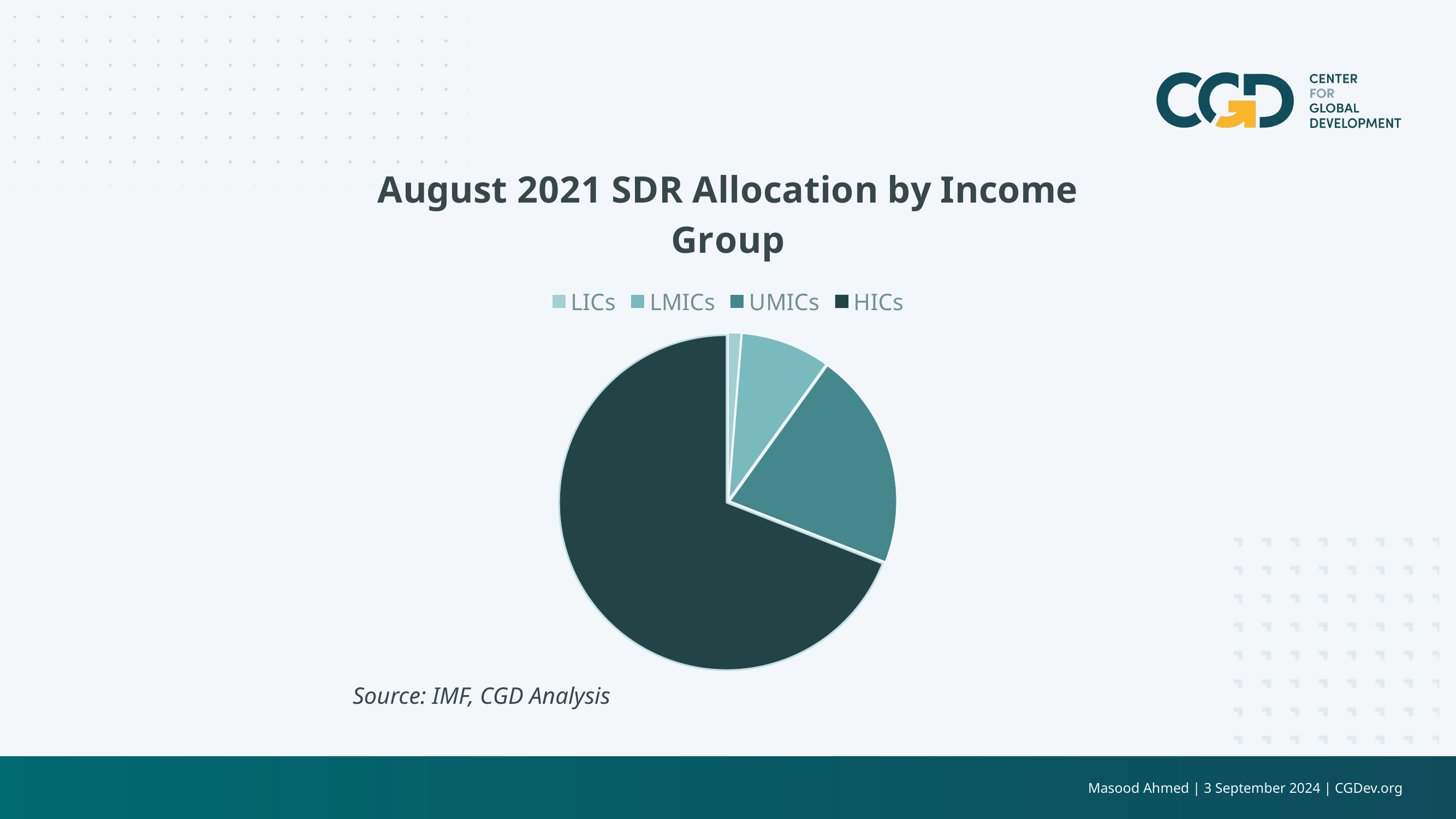
Which received a larger share of the SDR allocation, LICs or HICs? HICs What kind of chart is shown on the slide? Pie chart How many income groups (slices) does the pie chart show? 4 Which received a larger share of the SDR allocation, UMICs or LMICs? UMICs Which income group has the smallest share of the August 2021 SDR allocation? LICs Which received a larger share of the SDR allocation, LMICs or LICs? LMICs Which income group has the largest share of the August 2021 SDR allocation? HICs What is the title of the chart? August 2021 SDR Allocation by Income Group What source is cited for the chart? IMF, CGD Analysis Does the HICs slice account for more or less than half of the pie? more